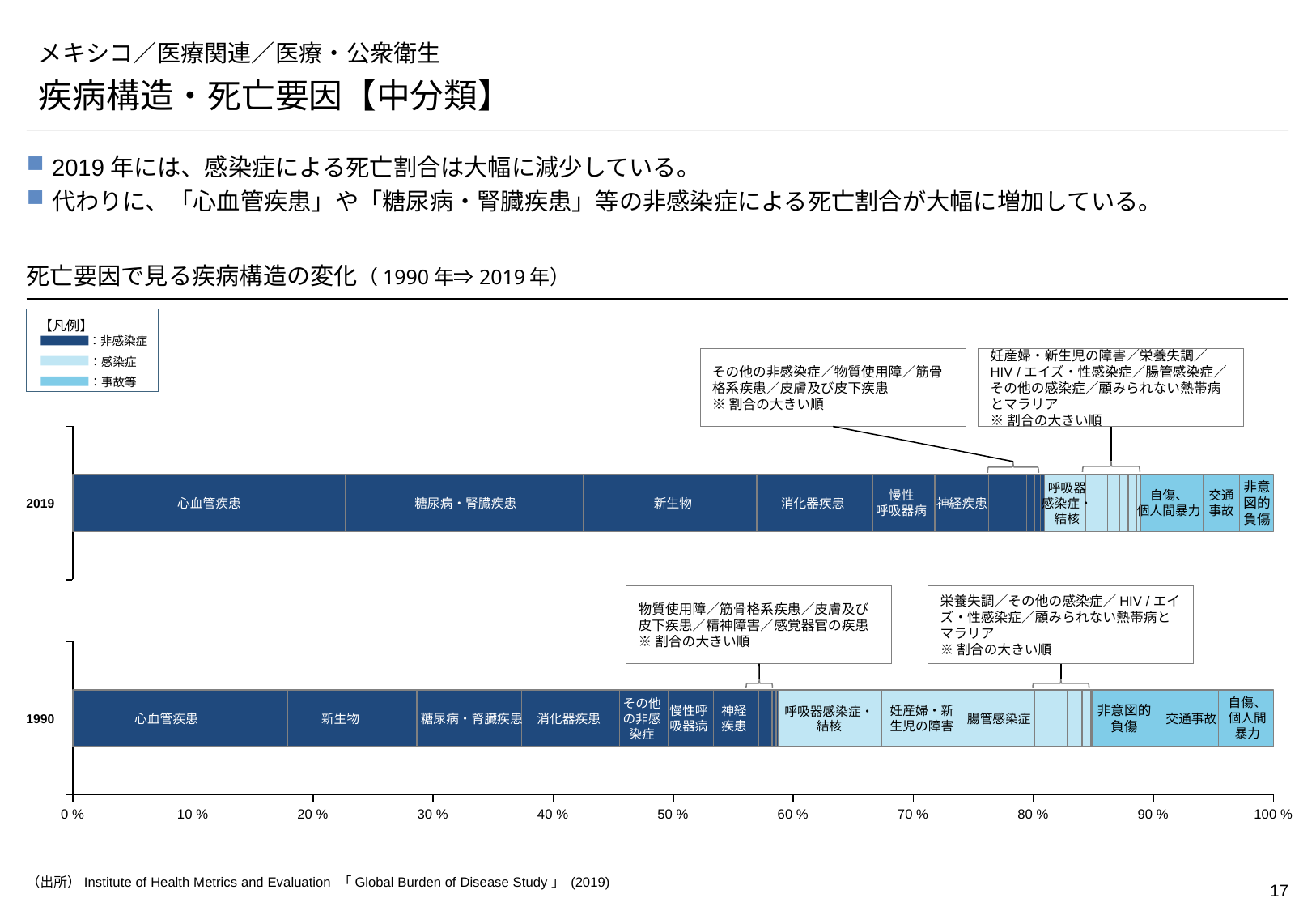
How many categories does the legend (凡例) list? 3 Which segment is the largest in the 1990 bar? 心血管疾患 Is the share of 新生物 in 2019 greater or less than 10%? greater Which year has the larger share for 糖尿病・腎臓疾患, 1990 or 2019? 2019 How many years (bars) does the chart compare? 2 Is the share of 心血管疾患 in 2019 greater or less than 20%? greater What is the title of the chart? 死亡要因で見る疾病構造の変化（1990年⇒2019年） Which segment is the largest in the 2019 bar? 心血管疾患 Which legend category is shown in the darkest blue? 非感染症 Is the share of 心血管疾患 in 1990 greater or less than 20%? less What kind of chart is shown on the slide? Stacked bar chart Which year has the larger share for 心血管疾患, 1990 or 2019? 2019